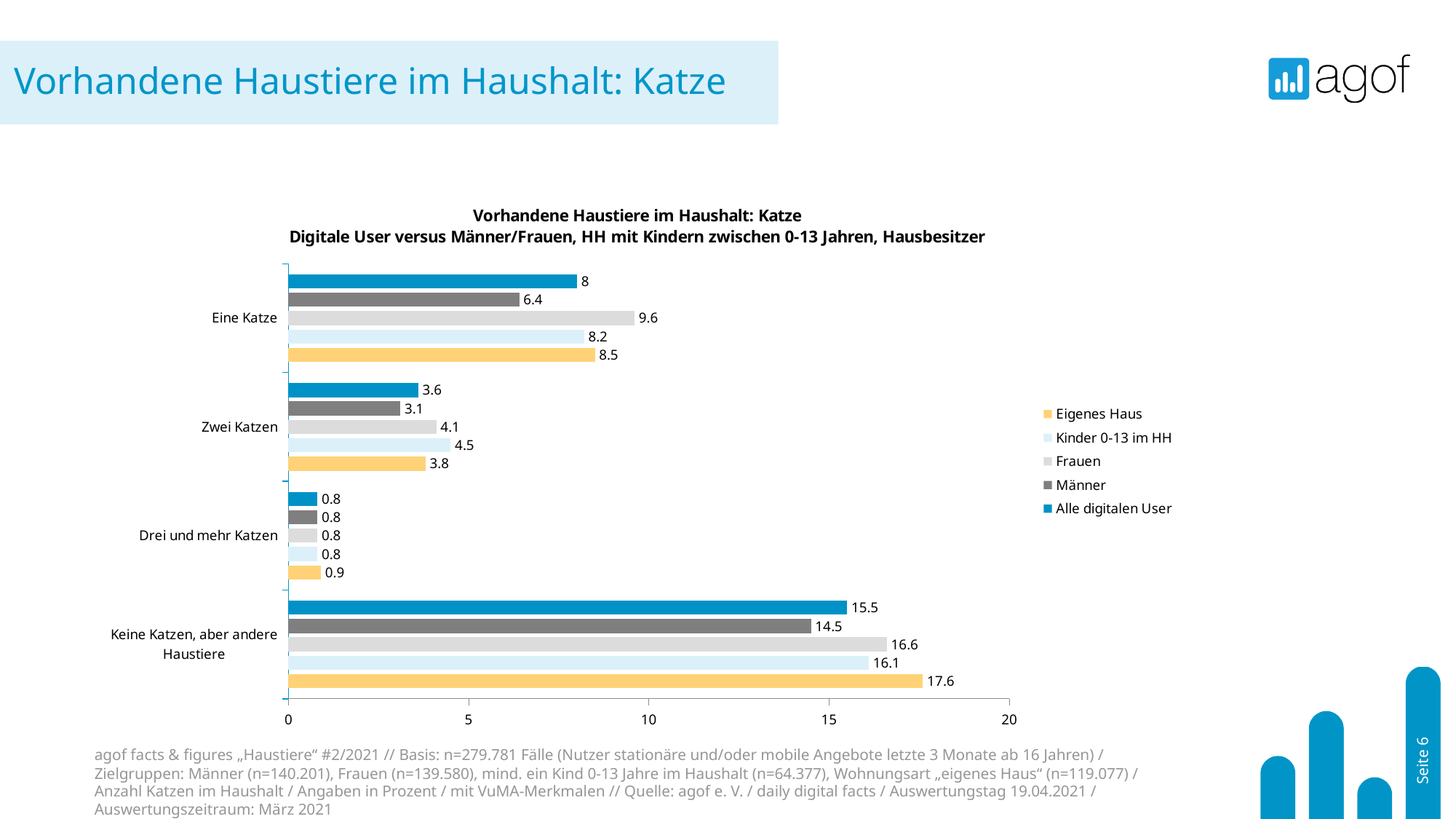
What is the difference between the Frauen and Männer values in the 'Eine Katze' category? 3.2 What is the value for Eigenes Haus in the 'Keine Katzen, aber andere Haustiere' category? 17.6 Which series has the lowest value in the 'Eine Katze' category? Männer What is the value for Frauen in the 'Eine Katze' category? 9.6 Which series has the highest value in the 'Keine Katzen, aber andere Haustiere' category? Eigenes Haus How many categories are shown on the y axis of the chart? 4 How many series does the legend list? 5 What kind of chart is shown on the slide? bar chart Which is larger in the 'Zwei Katzen' category: Kinder 0-13 im HH or Alle digitalen User? Kinder 0-13 im HH Is the value for Männer in the 'Keine Katzen, aber andere Haustiere' category greater or less than 15? less What is the value for Eigenes Haus in the 'Drei und mehr Katzen' category? 0.9 What is the value for Männer in the 'Zwei Katzen' category? 3.1